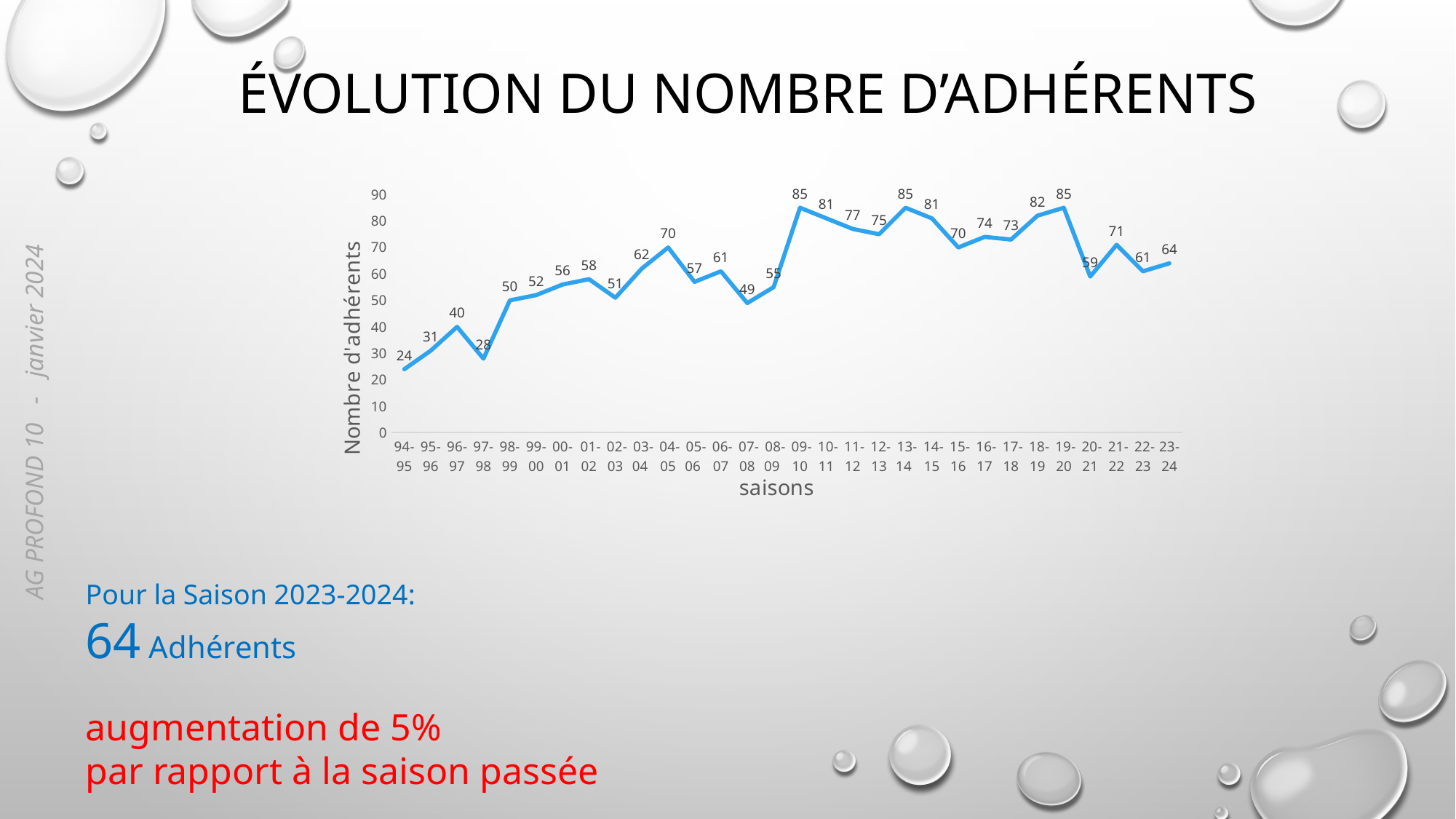
How many seasons are plotted on the chart? 30 What is the highest number of adhérents shown on the chart? 85 What type of chart is shown on the slide? Line chart Which season has the lowest number of adhérents? 94-95 What is the label of the vertical axis of the chart? Nombre d'adhérents What is the difference in adhérents between the 19-20 and 20-21 seasons? 26 What is the number of adhérents for the 09-10 season? 85 What is the number of adhérents for the 94-95 season? 24 Which season has more adhérents, 04-05 or 05-06? 04-05 What is the difference in adhérents between the 22-23 and 23-24 seasons? 3 What is the number of adhérents for the 07-08 season? 49 What is the number of adhérents for the 23-24 season? 64